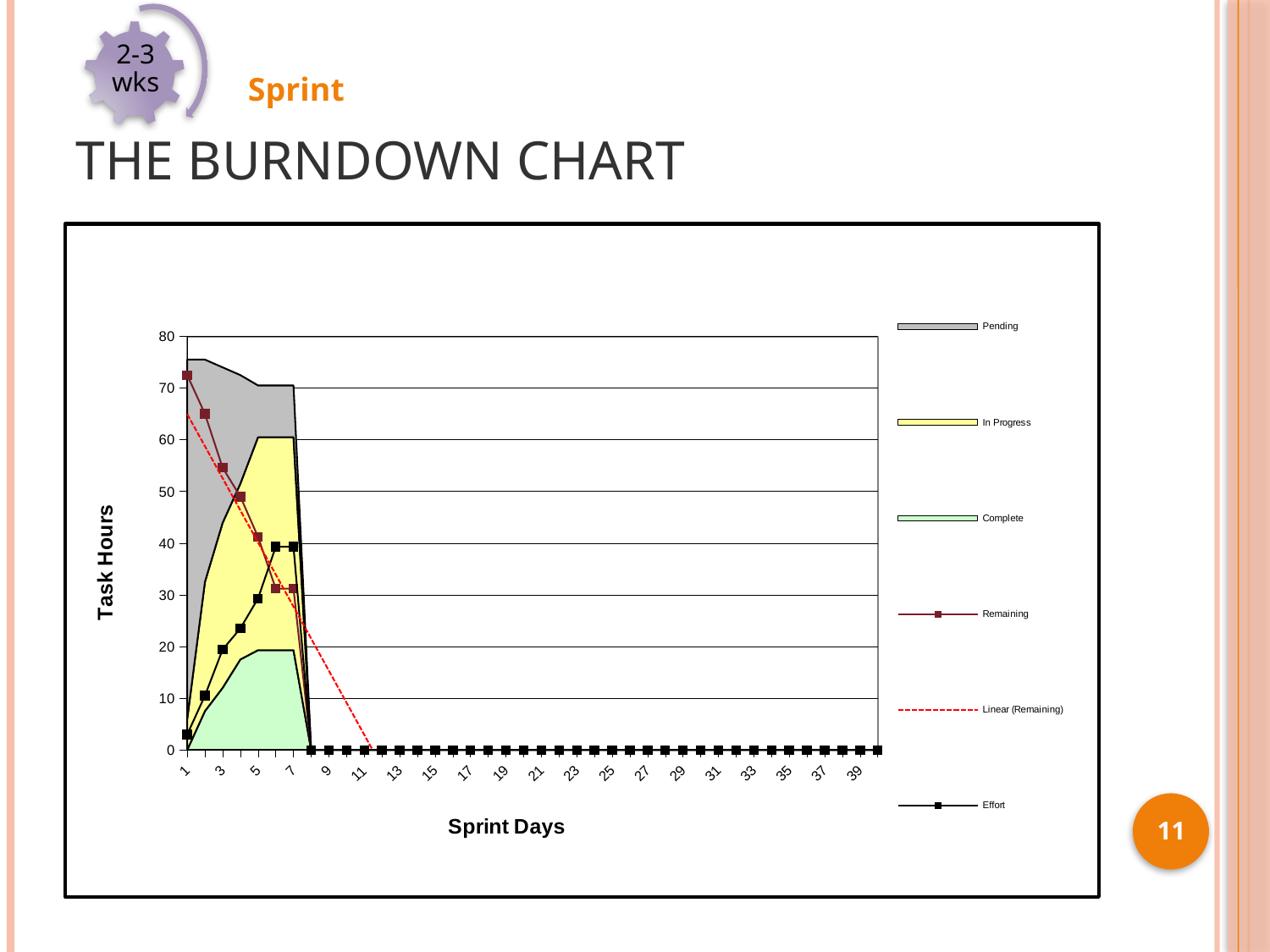
What is the title of the x axis? Sprint Days What is the title of the y axis? Task Hours On which sprint day is the Remaining series at its highest? Day 1 How many series does the legend list? 6 Is the Effort value on sprint day 4 greater or less than 20? greater What is the highest value shown on the y axis? 80 Which is larger on sprint day 1, the Remaining value or the Effort value? Remaining Is the Remaining value on sprint day 1 greater or less than 70? greater Is the Remaining value on sprint day 7 greater or less than 40? less Does the Remaining series rise or fall from sprint day 1 to sprint day 7? fall